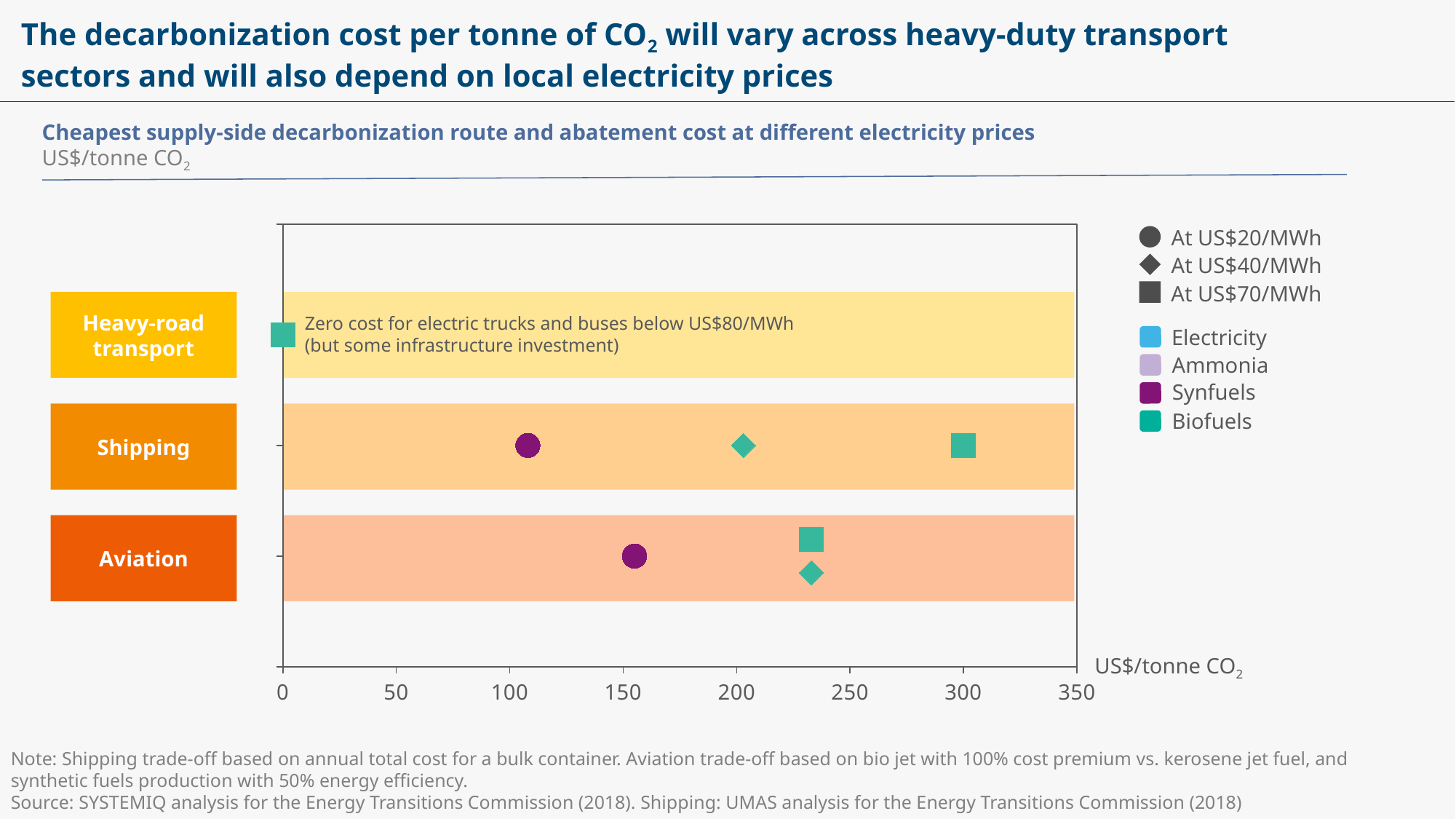
What kind of chart is shown on the slide? scatter chart How many electricity price levels does the legend list? 3 How many fuel types does the legend list? 4 Which sector has the higher abatement cost at US$70/MWh, Shipping or Aviation? Shipping Is the abatement cost for Aviation at US$70/MWh greater or less than 200? greater Is the abatement cost for Shipping at US$70/MWh greater or less than 250? greater Which sector has the higher abatement cost at US$20/MWh, Shipping or Aviation? Aviation How many heavy-duty transport sectors are plotted on the chart? 3 Which fuel is the cheapest decarbonization route for Shipping at US$20/MWh? Synfuels Is the abatement cost for Aviation at US$20/MWh greater or less than 200? less What is the abatement cost for Heavy-road transport at US$70/MWh? 0